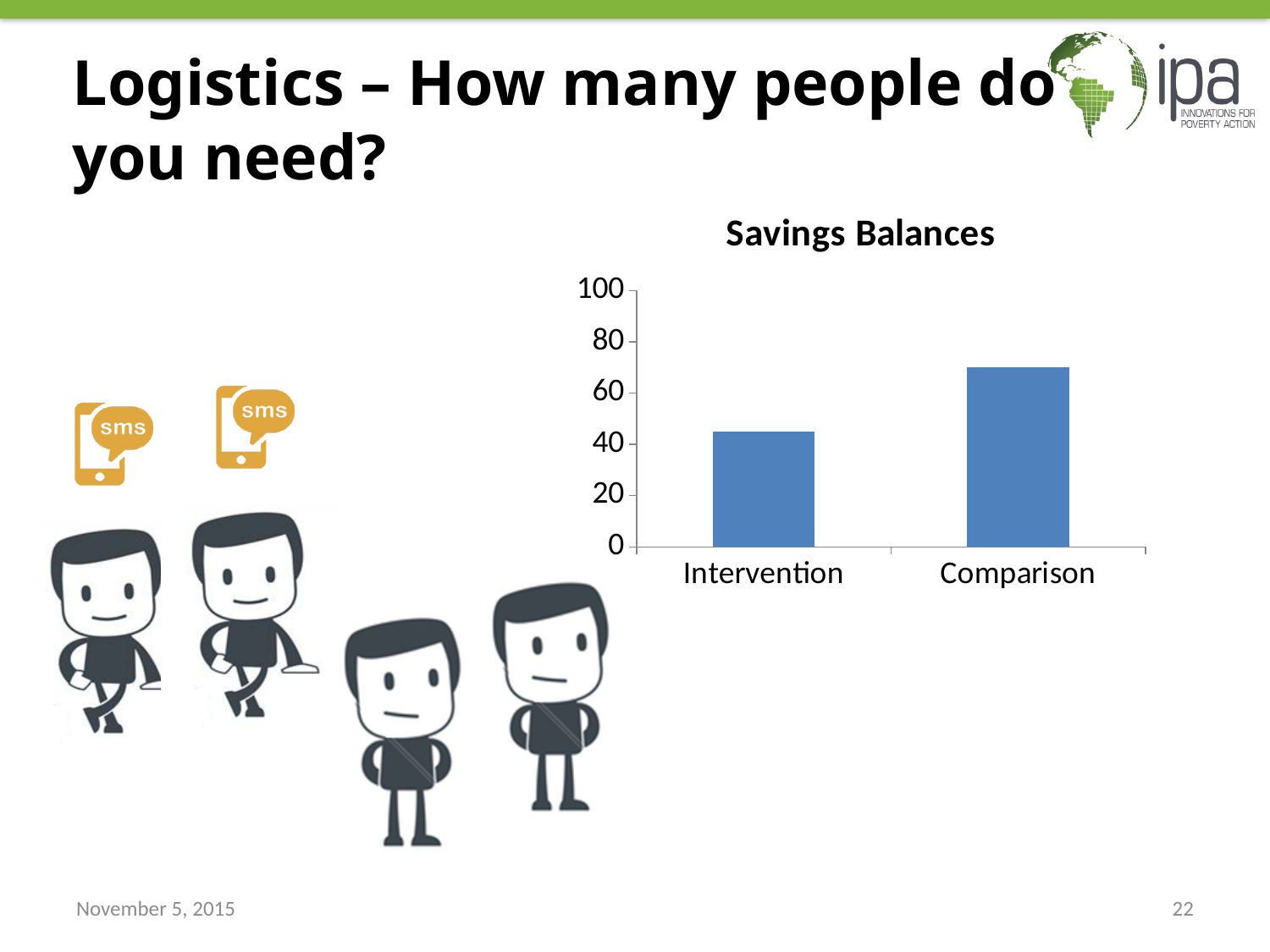
Is the value for Comparison greater or less than 60? greater What is the highest value shown on the y axis of the chart? 100 Which category has the highest savings balance? Comparison How many categories are shown on the x axis of the chart? 2 Which is larger, the value for Intervention or the value for Comparison? Comparison Is the value for Comparison greater or less than 80? less Which category has the lowest savings balance? Intervention Is the value for Intervention greater or less than 40? greater Do the values rise or fall from Intervention to Comparison? rise What is the title of the chart? Savings Balances What kind of chart is shown on the slide? bar chart